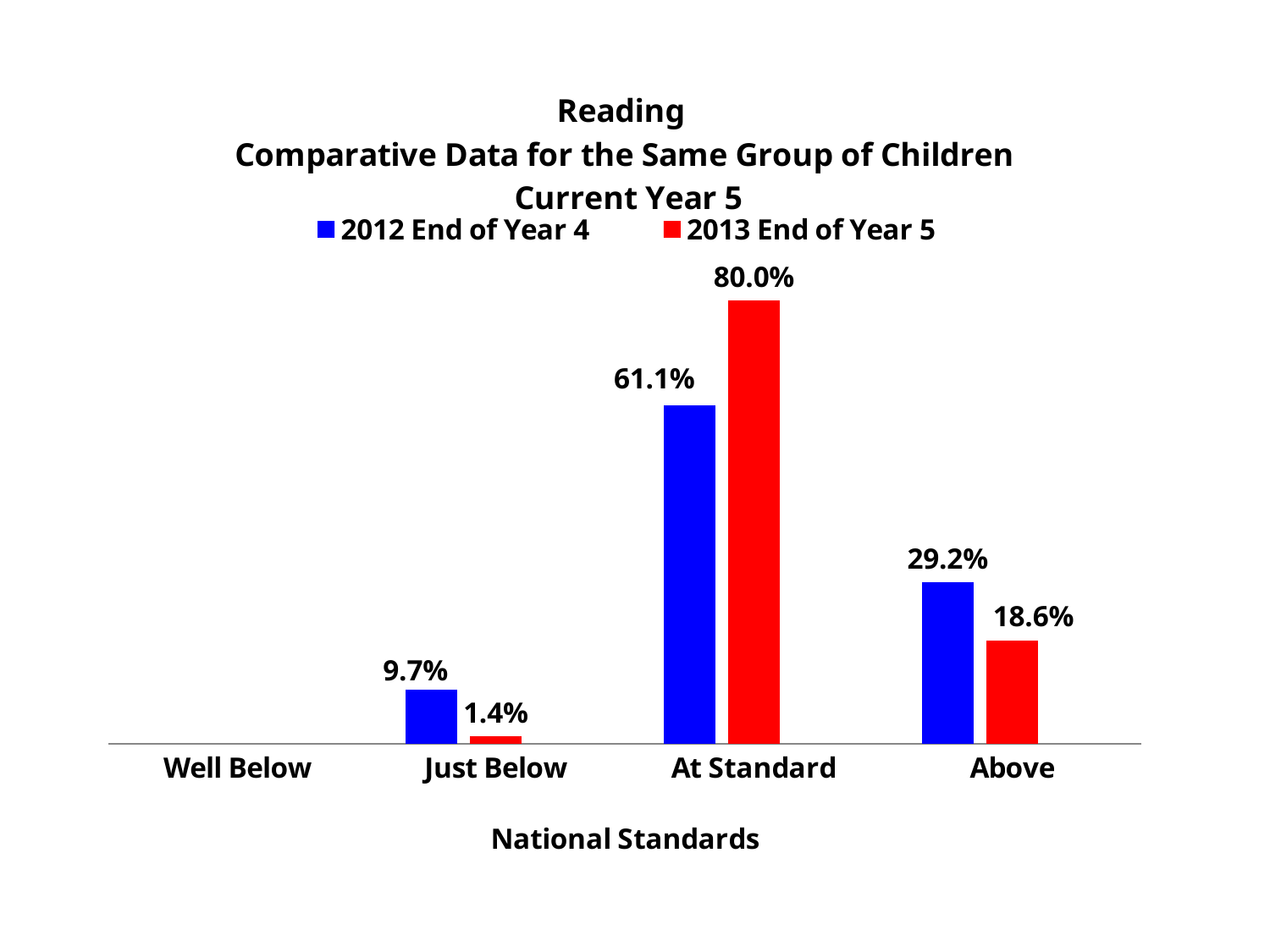
Which category has the highest value in the 2012 End of Year 4 series? At Standard How many series does the legend list? 2 What kind of chart is shown on the slide? Bar chart What is the x-axis title of the chart? National Standards What is the value for Above in the 2013 End of Year 5 series? 18.6% What is the difference between the 2012 End of Year 4 and 2013 End of Year 5 values for Above? 10.6% What is the value for Just Below in the 2012 End of Year 4 series? 9.7% What is the value for At Standard in the 2013 End of Year 5 series? 80.0% For Just Below, which series has the larger value: 2012 End of Year 4 or 2013 End of Year 5? 2012 End of Year 4 How many categories are shown on the x axis? 4 What is the difference between the 2013 End of Year 5 and 2012 End of Year 4 values for At Standard? 18.9%